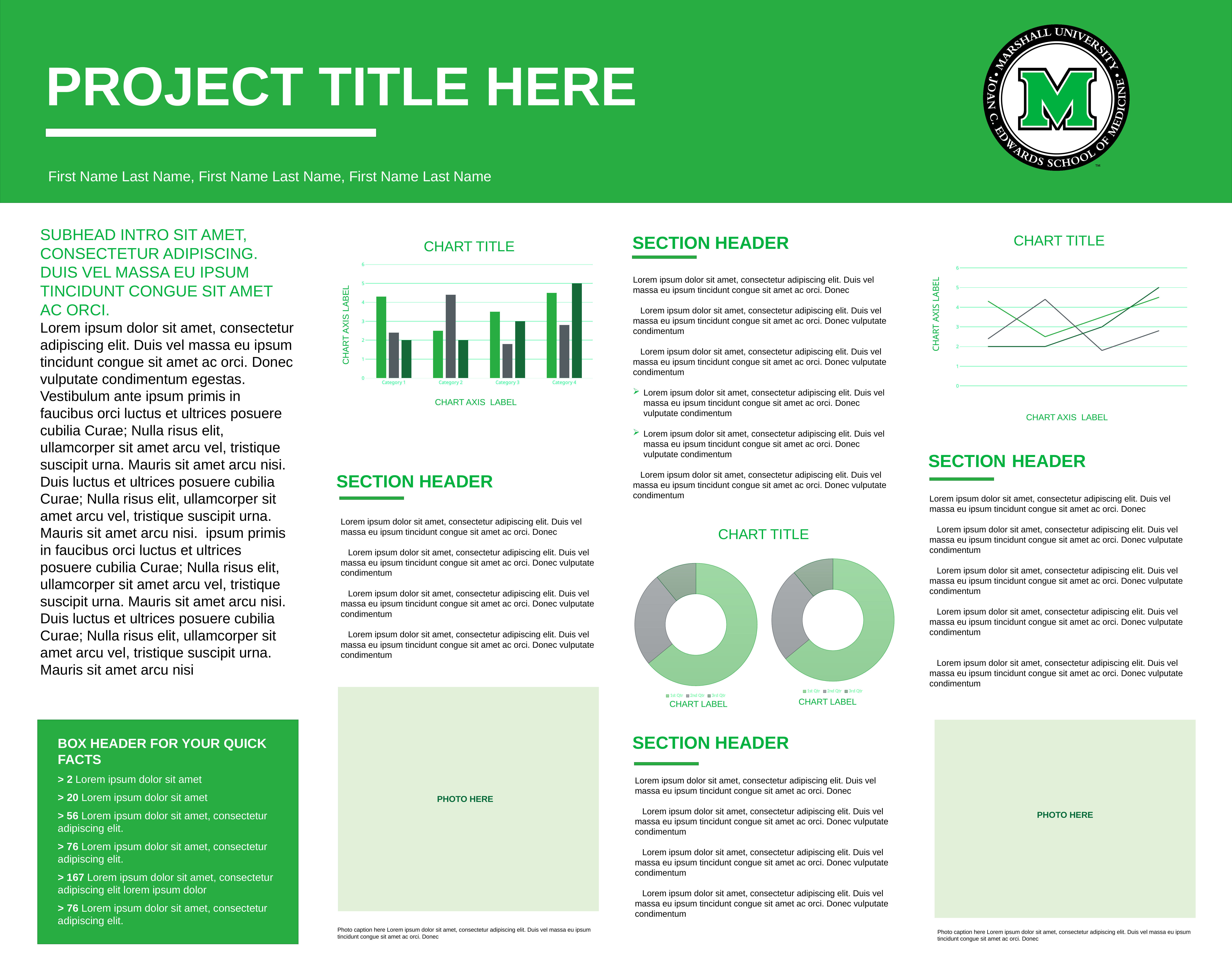
In the bar chart in the second column, which bar is the tallest in Category 4? the dark green bar What is the y-axis label of the bar chart in the second column? CHART AXIS LABEL How many slices does each donut chart in the third column have? 3 In the bar chart in the second column, is the gray bar for Category 2 greater or less than 4? greater In the bar chart in the second column, which bar is the tallest in Category 2? the gray bar What kind of chart is the chart at the top of the second column, titled CHART TITLE? bar chart In the bar chart in the second column, how many bars are there for each category? 3 What kind of chart is the chart at the top of the right-hand column? line chart In the bar chart in the second column, is the gray bar for Category 3 greater or less than 2? less In the bar chart in the second column, which bar is the shortest in Category 3? the gray bar In the bar chart in the second column, how many categories are shown on the x axis? 4 What kind of charts are the two charts in the middle of the third column? pie (donut) charts